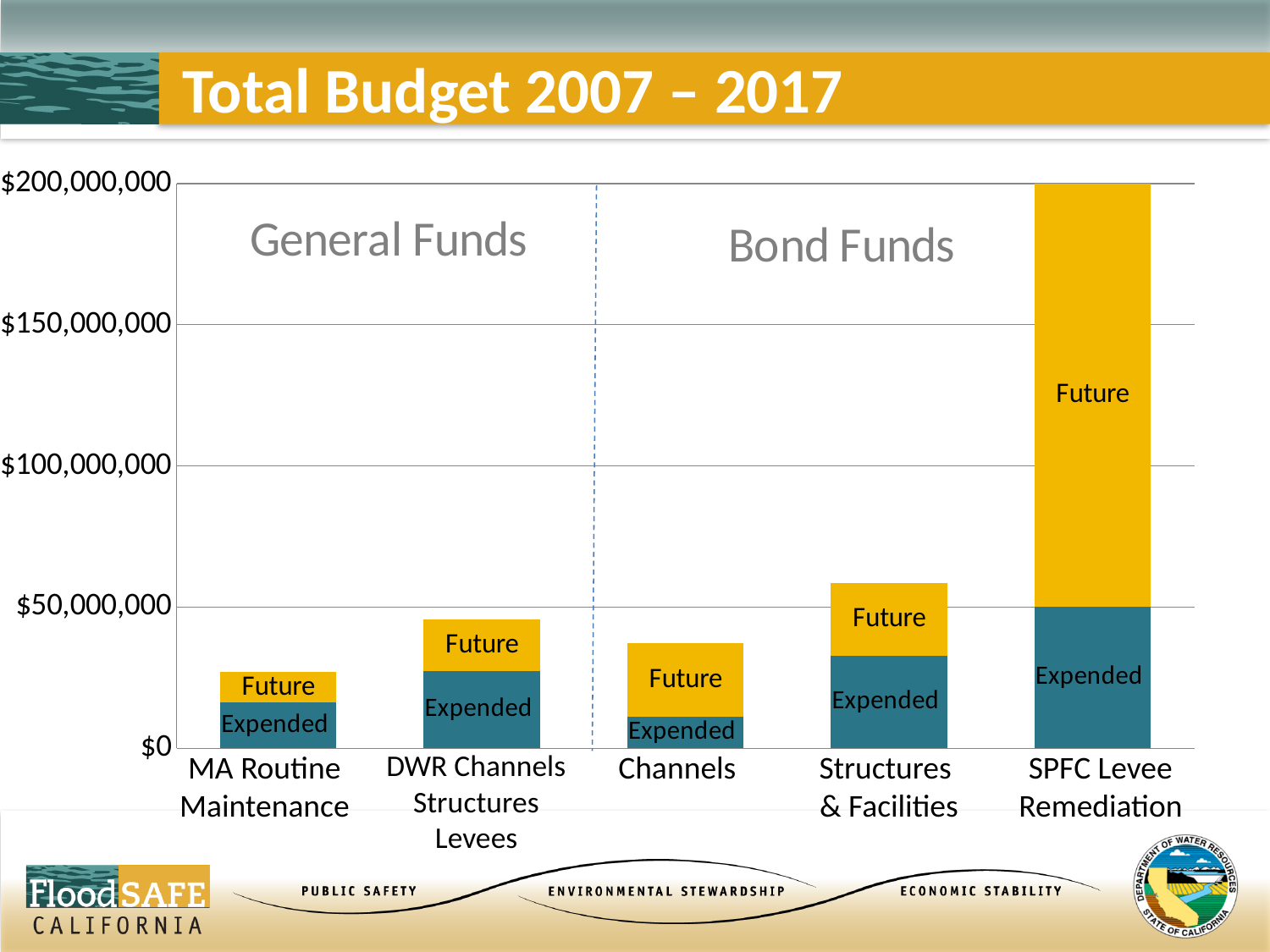
How many categories are shown along the x axis of the chart? 5 Is the total value for Structures & Facilities greater or less than $50,000,000? greater What kind of chart is shown on the slide? bar chart Is the Expended value for SPFC Levee Remediation greater or less than $100,000,000? less How many series (segments) make up each stacked bar in the chart? 2 Is the total value for SPFC Levee Remediation greater or less than $150,000,000? greater What is the title of the chart on the slide? Total Budget 2007 – 2017 Which categories in the chart fall under Bond Funds? Channels, Structures & Facilities, SPFC Levee Remediation Which category has the lowest total budget in the chart? MA Routine Maintenance Which has the larger total budget, Channels or Structures & Facilities? Structures & Facilities Which category has the highest total budget in the chart? SPFC Levee Remediation